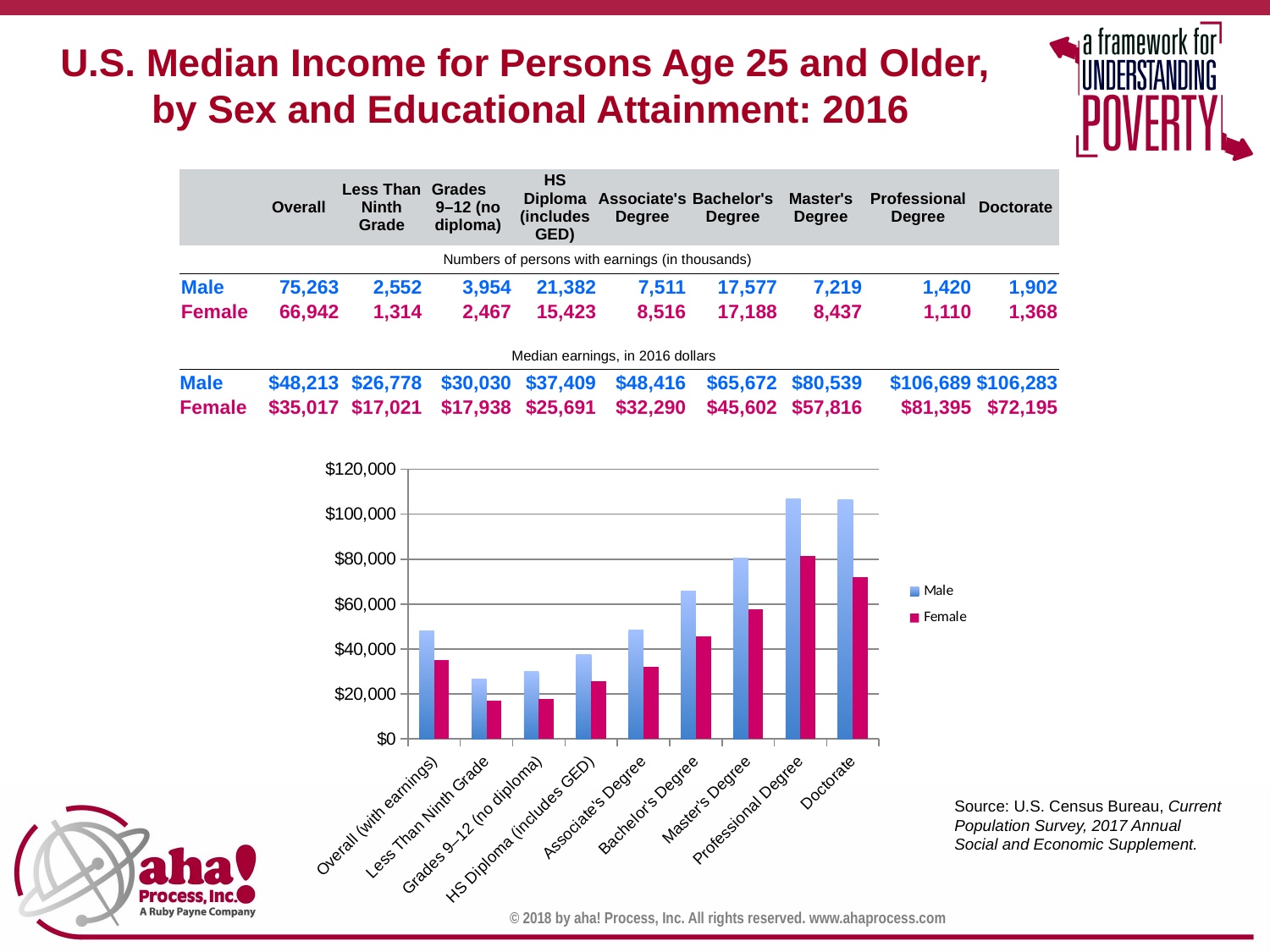
How many educational attainment categories are plotted along the x axis of the chart? 9 Which is larger: Male median earnings for Bachelor's Degree or Female median earnings for Master's Degree? Male median earnings for Bachelor's Degree What kind of chart is shown on the slide? bar chart What are the median earnings for Male with a Master's Degree? $80,539 Do the Male bars rise or fall from Less Than Ninth Grade through Professional Degree? rise What is the difference between Male and Female median earnings for Master's Degree? $22,723 Which category has the lowest median earnings for Male? Less Than Ninth Grade How many series does the chart's legend list? 2 Which category has the highest median earnings for Female? Professional Degree What colour represents the Female series in the chart? pink Is the Female median earnings value for Doctorate greater or less than $80,000? less What are the median earnings for Female with a Bachelor's Degree? $45,602